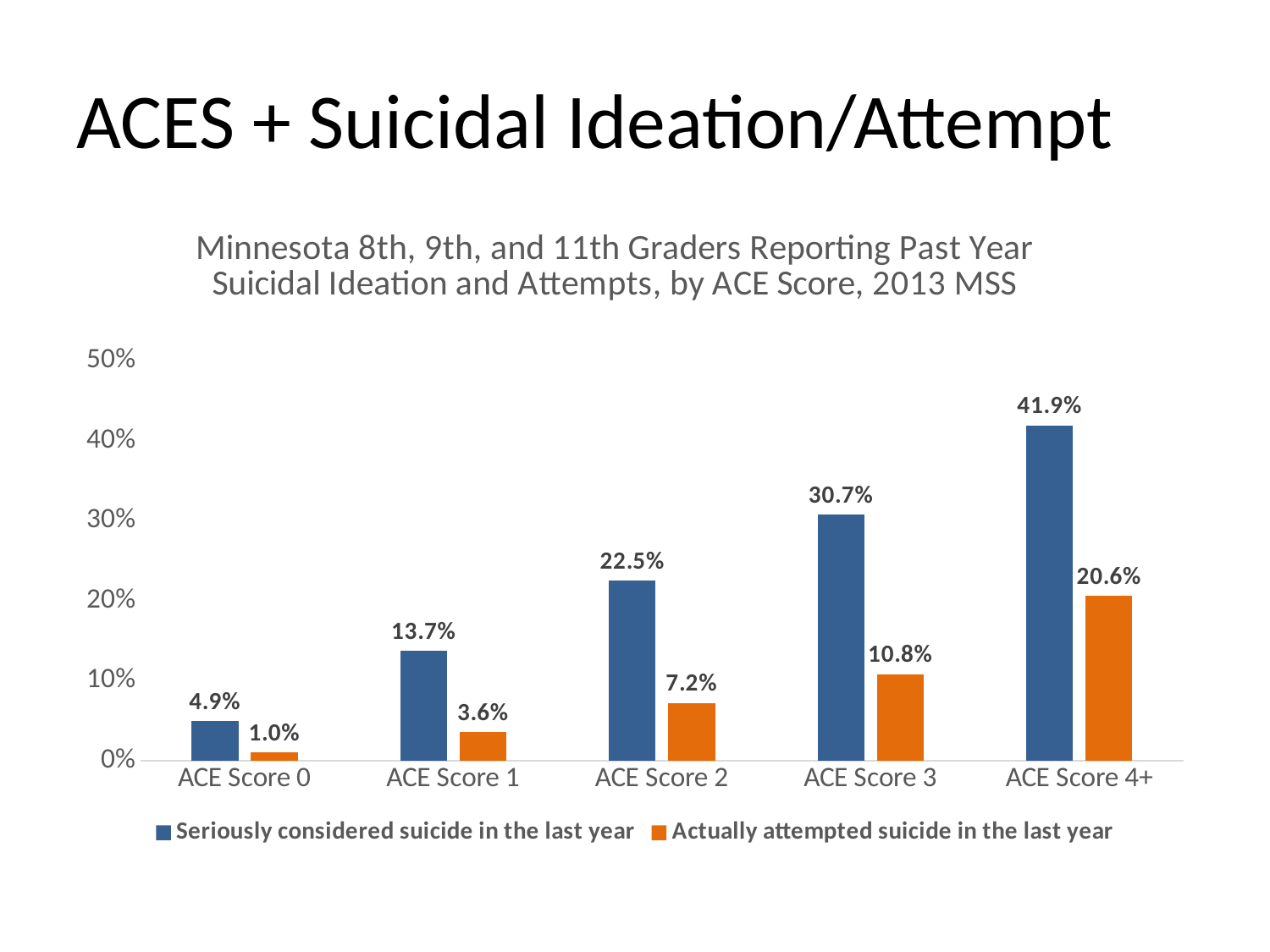
What is the value for 'Seriously considered suicide in the last year' at ACE Score 1? 13.7% What percentage of students with ACE Score 4+ seriously considered suicide in the last year? 41.9% What percentage of students with ACE Score 2 actually attempted suicide in the last year? 7.2% How many series does the legend list? 2 Is the 'Seriously considered suicide in the last year' value for ACE Score 3 greater or less than 20%? greater Which ACE Score category has the lowest value for 'Seriously considered suicide in the last year'? ACE Score 0 Do the 'Seriously considered suicide in the last year' values rise or fall as the ACE Score increases? Rise How many ACE Score categories are shown on the x axis? 5 What kind of chart is shown on the slide? Bar chart What is the difference between the 'Seriously considered suicide' and 'Actually attempted suicide' values at ACE Score 3? 19.9% Which is larger: the 'Actually attempted suicide' value at ACE Score 4+ or the 'Seriously considered suicide' value at ACE Score 1? Actually attempted suicide at ACE Score 4+ Which ACE Score category has the highest value for 'Actually attempted suicide in the last year'? ACE Score 4+